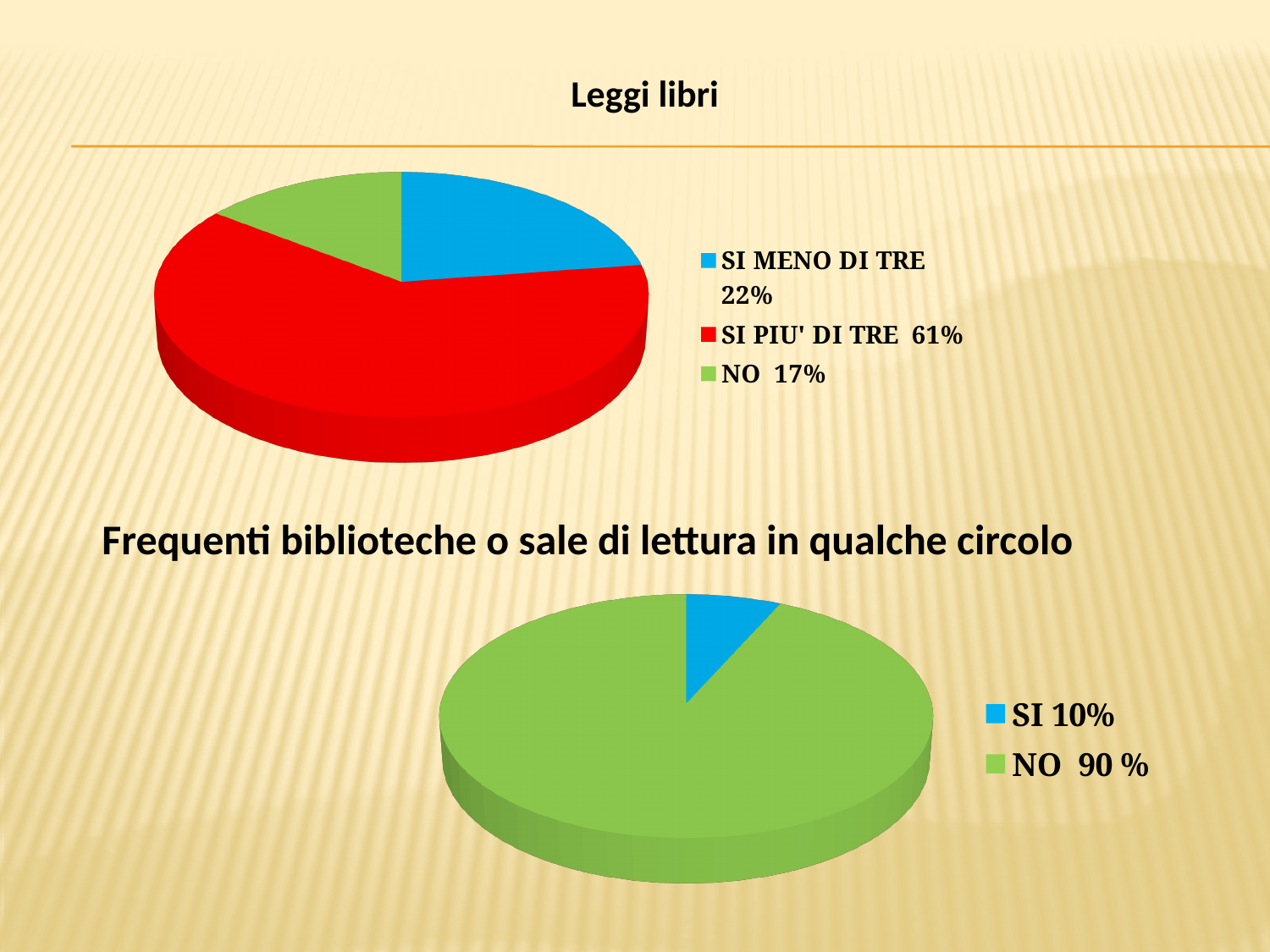
In the 'Leggi libri' chart, which category has the largest slice? SI PIU' DI TRE In the 'Leggi libri' chart, which category has the smallest slice? NO In the 'Leggi libri' chart, what is the difference in percentage points between 'SI PIU' DI TRE' and 'SI MENO DI TRE'? 39 In the 'Leggi libri' chart, how many categories does the legend list? 3 In the 'Frequenti biblioteche o sale di lettura in qualche circolo' chart, which is larger, 'SI' or 'NO'? NO In the 'Leggi libri' chart, what share is shown for 'NO'? 17% What kind of chart is the 'Leggi libri' chart? Pie chart In the 'Leggi libri' chart, what share is shown for 'SI PIU' DI TRE'? 61% In the 'Frequenti biblioteche o sale di lettura in qualche circolo' chart, what share is shown for 'SI'? 10% In the 'Frequenti biblioteche o sale di lettura in qualche circolo' chart, what colour is the 'NO' slice? Green In the 'Leggi libri' chart, what share is shown for 'SI MENO DI TRE'? 22% In the 'Frequenti biblioteche o sale di lettura in qualche circolo' chart, what share is shown for 'NO'? 90 %